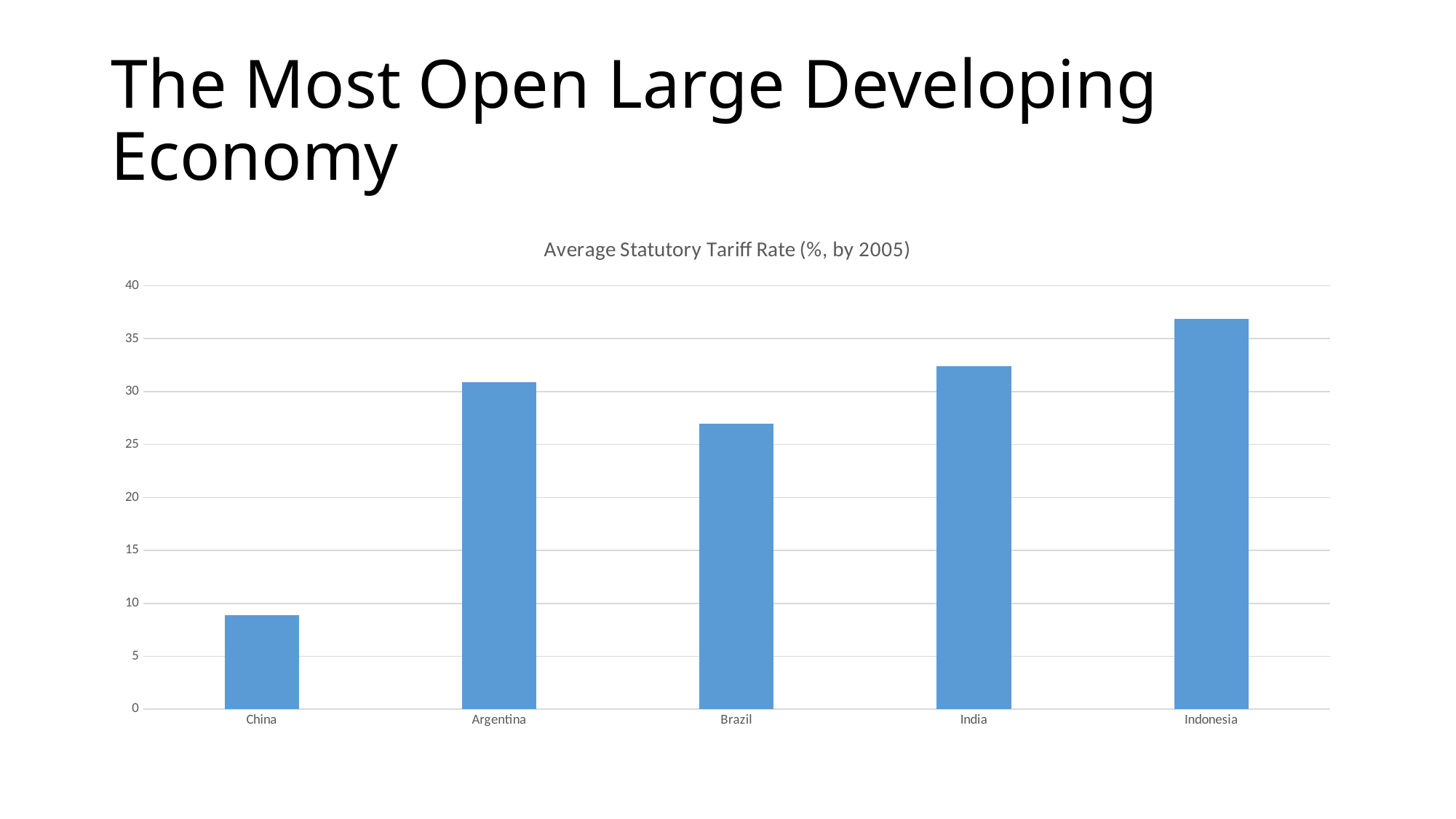
Is the value for Brazil greater or less than 25? greater Which has a higher average statutory tariff rate, China or Brazil? Brazil Is the value for China greater or less than 10? less Which country has the highest average statutory tariff rate? Indonesia How many countries are shown on the chart? 5 Is the value for India greater or less than 35? less Which country has the lowest average statutory tariff rate? China What is the title of the chart? Average Statutory Tariff Rate (%, by 2005) Which has a higher average statutory tariff rate, Brazil or Argentina? Argentina What type of chart is shown on the slide? bar chart